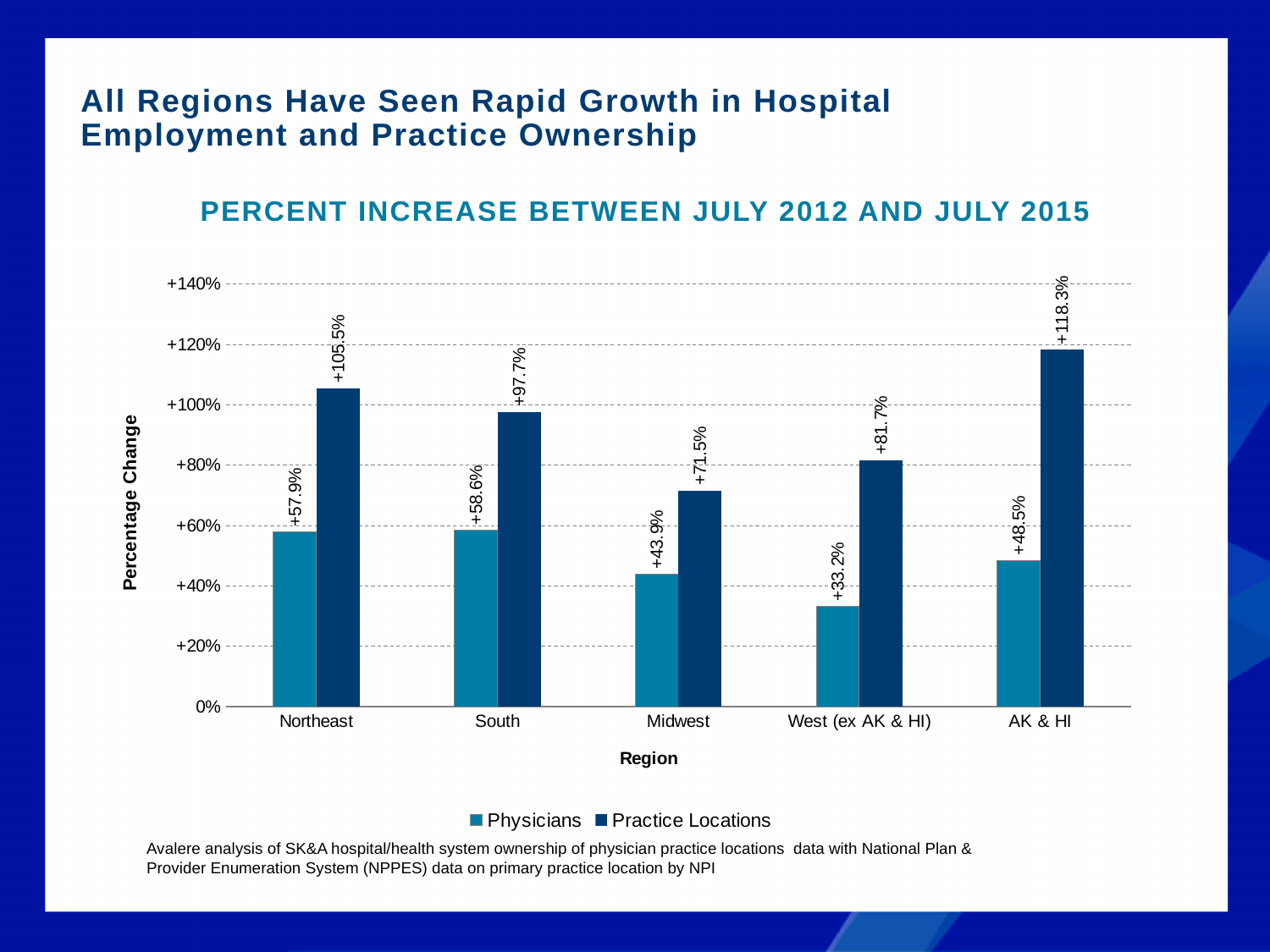
What is the percent increase in Practice Locations for the AK & HI region? +118.3% What is the difference between the Practice Locations and Physicians percent increases for the South region? 39.1 percentage points Is the Practice Locations value for the Northeast greater or less than +100%? greater How many series does the legend list? 2 Which region has the lowest percent increase in Physicians? West (ex AK & HI) What is the percent increase in Physicians for the Northeast region? +57.9% How many regions are shown on the x axis? 5 Which is larger for the Midwest region: the Physicians increase or the Practice Locations increase? Practice Locations What is the label on the y axis of the chart? Percentage Change Which region has the highest percent increase in Practice Locations? AK & HI What is the percent increase in Physicians for the West (ex AK & HI) region? +33.2% What kind of chart is shown on the slide? Bar chart